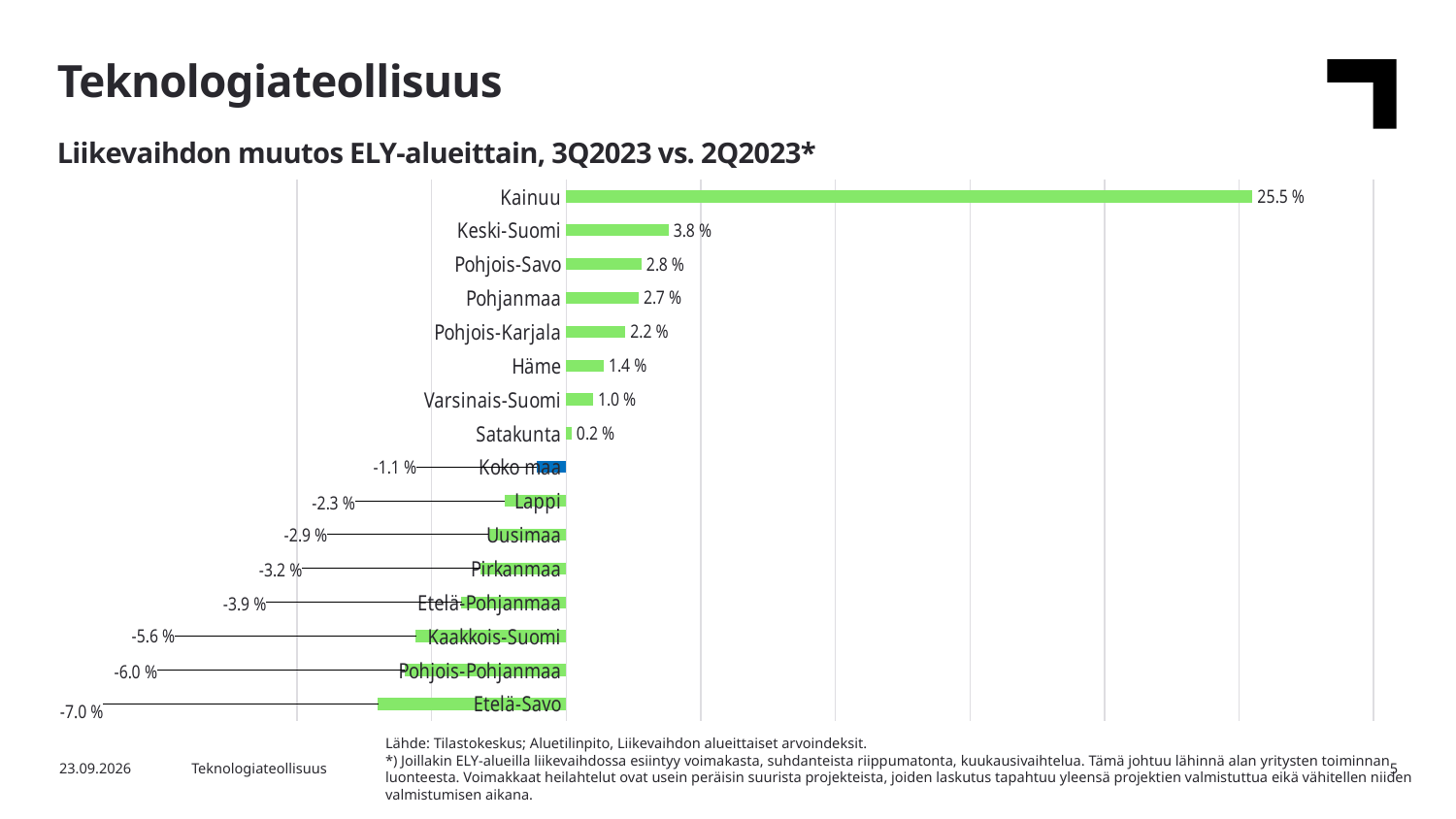
What is the value for Kainuu? 25.5 % What is the title of the chart? Liikevaihdon muutos ELY-alueittain, 3Q2023 vs. 2Q2023* Which has a larger value, Pohjois-Karjala or Varsinais-Suomi? Pohjois-Karjala Which region has the lowest value? Etelä-Savo What is the value for Koko maa? -1.1 % What is the value for Etelä-Savo? -7.0 % Which region has the highest value? Kainuu How many categories are shown in the chart? 16 What kind of chart is shown on the slide? Bar chart What is the difference between the values for Kainuu and Etelä-Savo? 32.5 % What is the value for Häme? 1.4 % What is the difference between the values for Keski-Suomi and Pohjois-Savo? 1.0 %